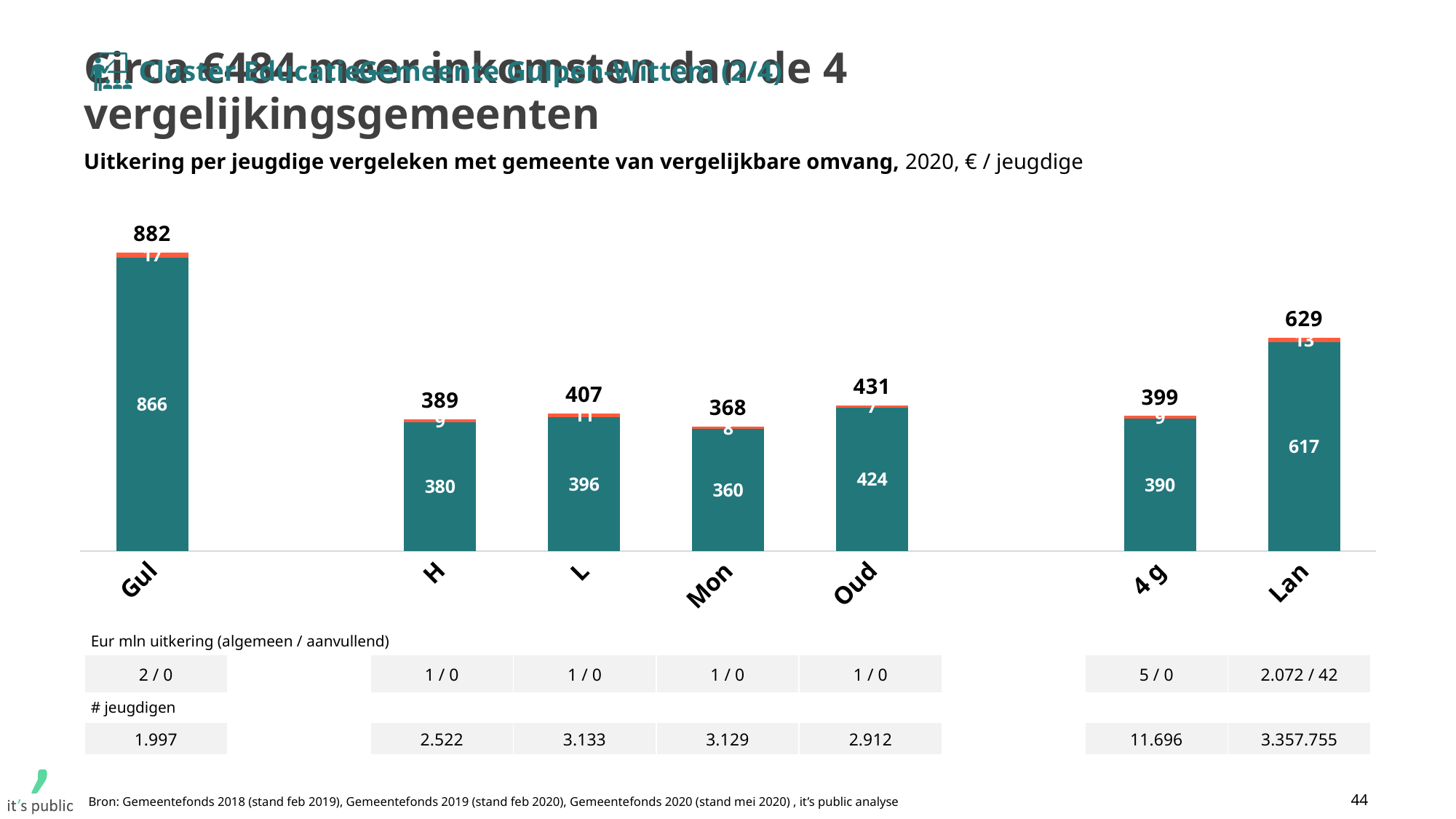
What is the value of the large teal segment of the Lan bar? 617 What kind of chart is shown on the slide? Stacked bar chart Which category has the lowest total value? Mon What is the value of the teal segment of the Oud bar? 424 According to the chart subtitle, in what unit are the values expressed? € / jeugdige Which category has the highest total value? Gul What is the difference between the total for Lan and the total for 4 g? 230 How many categories are shown on the x axis of the chart? 7 Which has a higher total, Mon or 4 g? 4 g Which has a higher total, L or H? L What is the total value shown above the bar for Gul? 882 What is the difference between the total for Gul and the total for Oud? 451